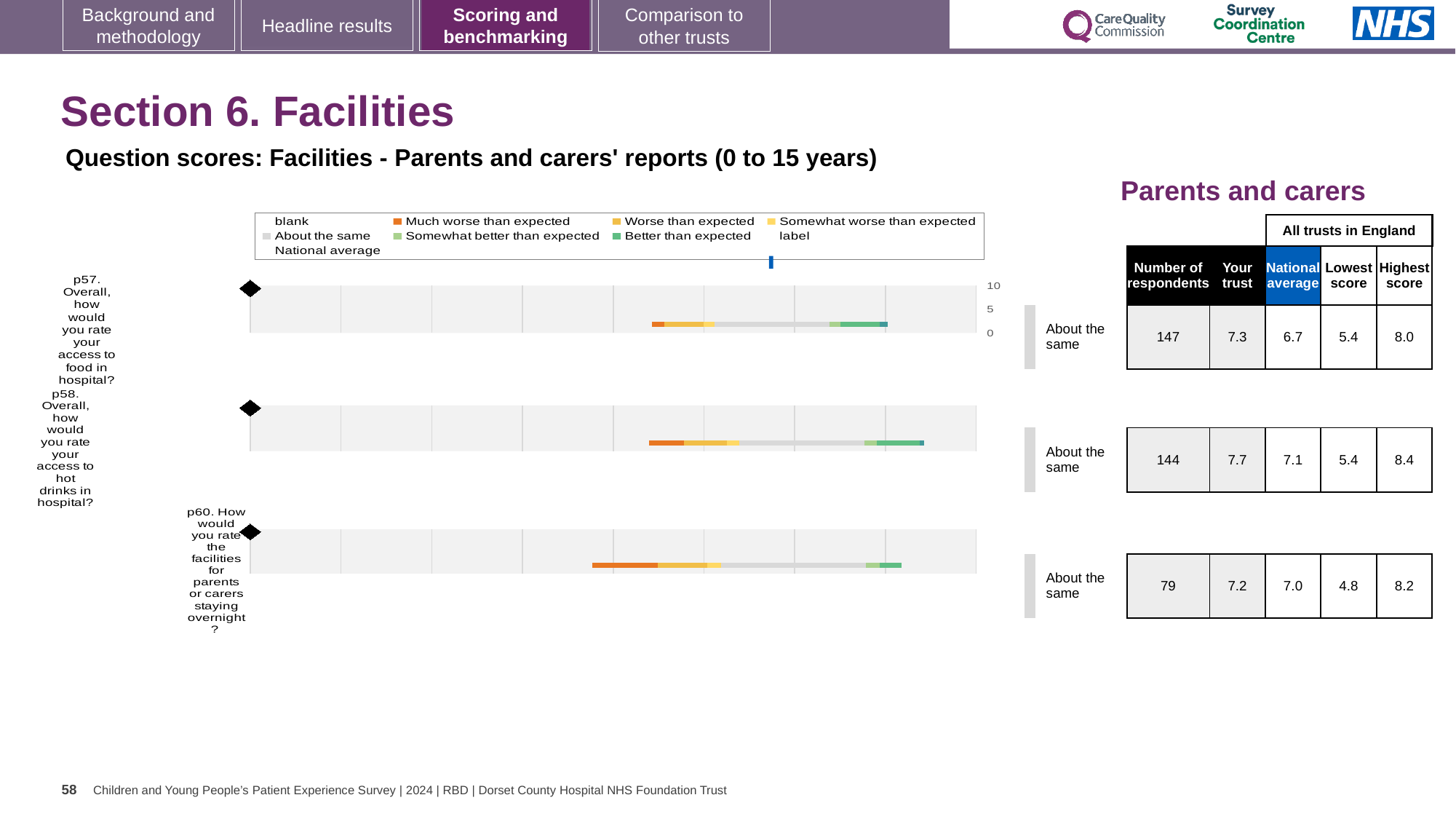
What is the difference between the 'Your trust' score and the national average for p58? 0.6 What kind of chart is used to show the question scores for Facilities? Bar chart Which question has the fewest respondents? p60 (facilities for parents or carers staying overnight) For p57, is the 'Your trust' score or the national average higher? Your trust How many questions (bars) are plotted in the Facilities chart? 3 What is the lowest score among all trusts in England for p60? 4.8 Which question has the highest 'Your trust' score? p58 (access to hot drinks in hospital) What is the national average score for p58 (access to hot drinks in hospital)? 7.1 What benchmark category is shown for all three Facilities questions? About the same What is the 'Your trust' score for p57 (access to food in hospital)? 7.3 How many respondents answered p60 (facilities for parents or carers staying overnight)? 79 What is the highest score among all trusts in England for p58? 8.4